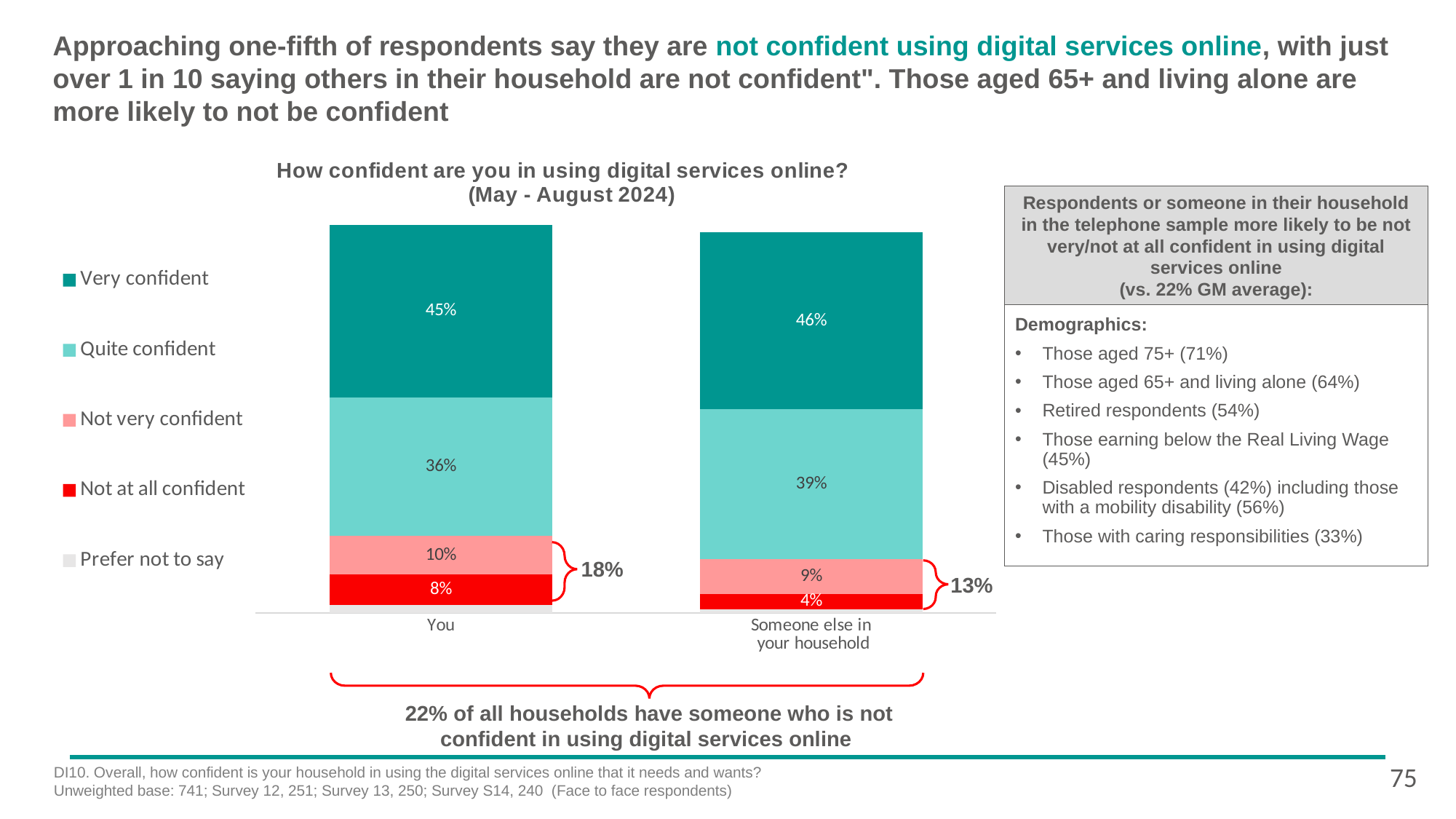
What percentage of respondents are 'Not at all confident' in the 'You' bar? 8% What type of chart is shown on the slide? Stacked bar chart What percentage of respondents say they are very confident in using digital services online for the 'You' bar? 45% Which segment is the largest in the 'You' bar? Very confident What combined percentage is shown by the brace next to the 'Someone else in your household' bar? 13% What combined percentage is shown by the brace next to the 'You' bar for not very/not at all confident? 18% Which bar has the higher 'Quite confident' value, 'You' or 'Someone else in your household'? Someone else in your household How many bars (categories) are plotted on the chart? 2 What is the difference between the 'Not at all confident' values for 'You' and 'Someone else in your household'? 4% How many series does the legend list? 5 What percentage is shown for 'Quite confident' in the 'Someone else in your household' bar? 39% What is the 'Not very confident' value for 'Someone else in your household'? 9%